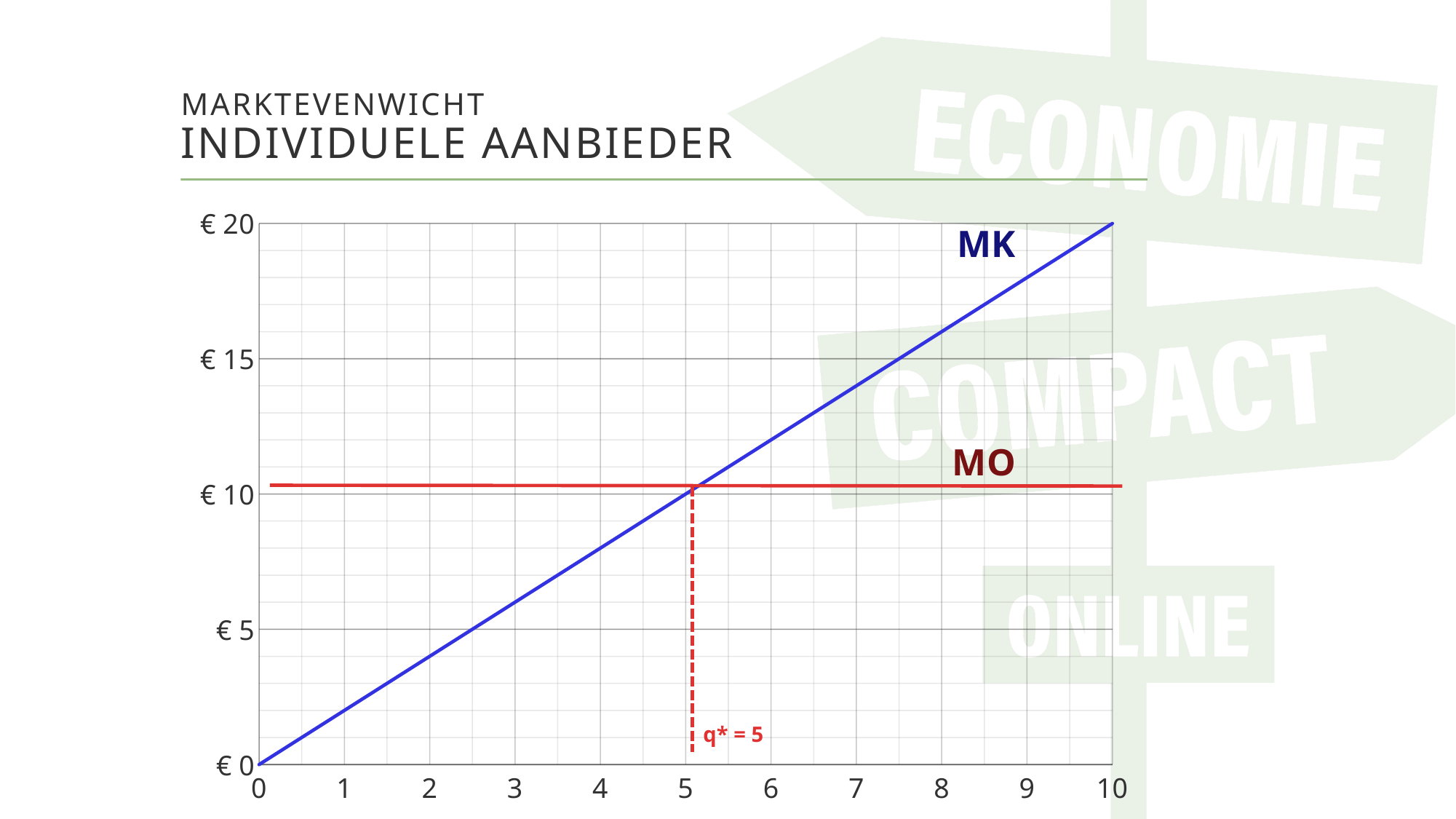
At quantity 2, which line is higher, MK or MO? MO What kind of chart is shown on the slide? line chart Does the MK line rise or fall as quantity increases along the x axis? rise What is the value of q* marked on the chart? 5 At quantity 8, which line is higher, MK or MO? MK How many lines (series) are labelled on the chart? 2 Is the value of the MO line greater or less than € 15? less What are the labels of the two lines on the chart? MK and MO Does the MO line rise, fall or stay flat along the x axis? stay flat What colour is the MK line? blue What is the value of MK at quantity 0? € 0 What is the value of MK at quantity 10? € 20